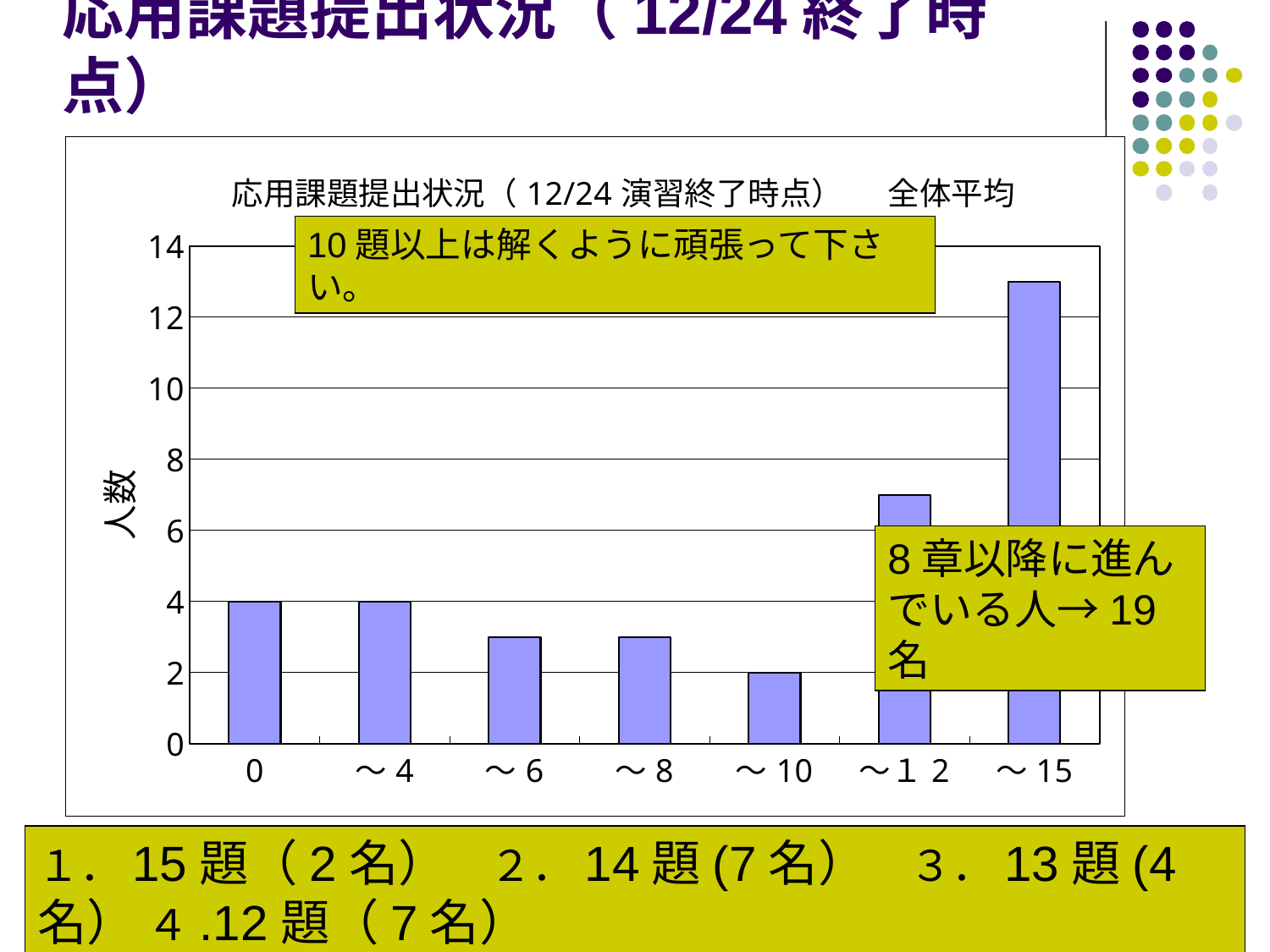
What is the label of the y axis of the chart? 人数 Which category has the lowest value in the chart? ～10 Which is larger, the value for ～8 or the value for ～10? ～8 Is the value for ～15 greater or less than 12? greater Is the value for ～6 greater or less than 4? less What is the value for the category ～10? 2 What kind of chart is shown on the slide? bar chart Is the value for ～12 greater or less than 6? greater How many categories are shown on the x axis of the chart? 7 Which category has the highest value in the chart? ～15 What is the value for the category 0? 4 What is the difference between the values for 0 and ～10? 2